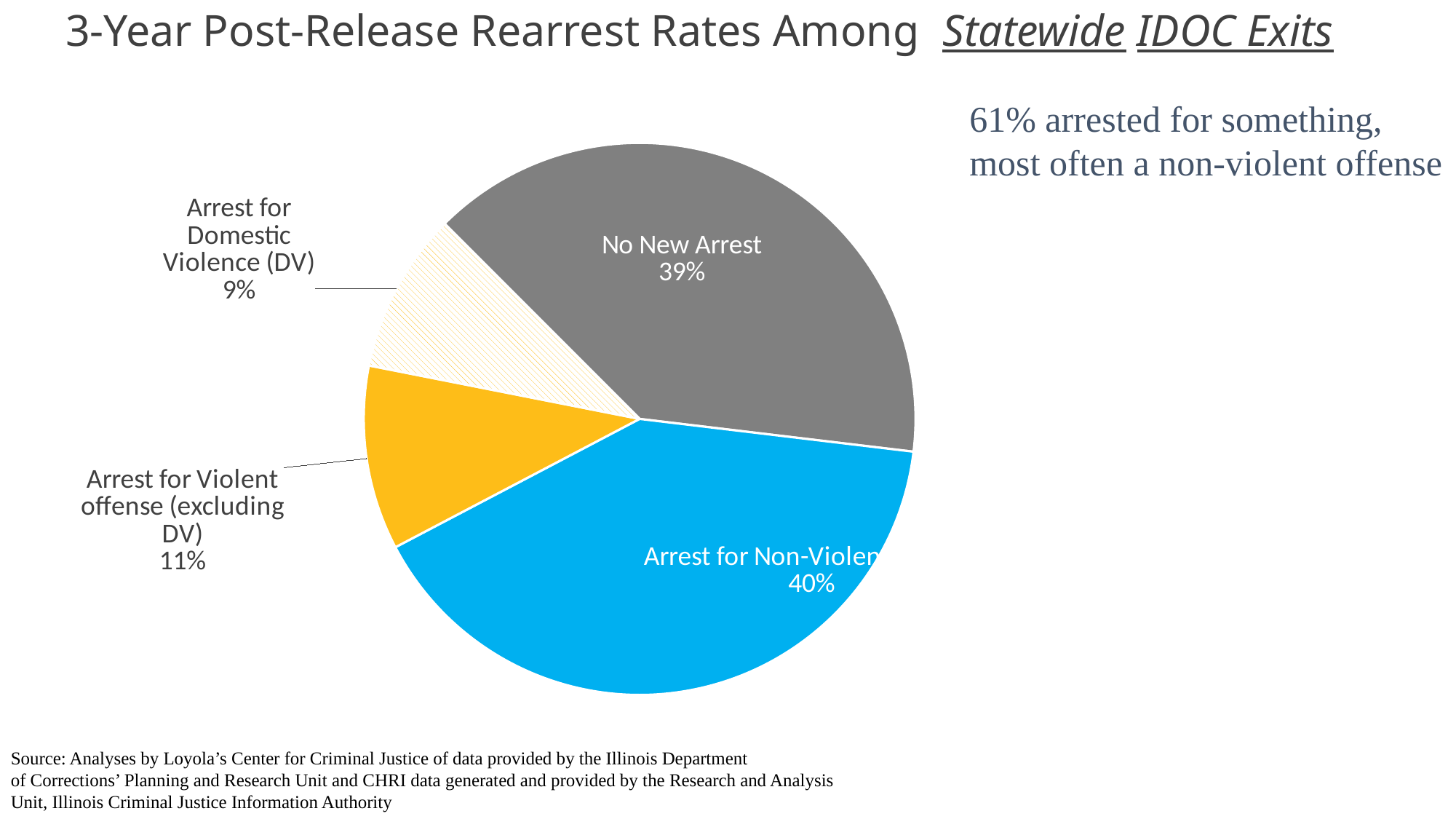
Which is larger: 'Arrest for Violent offense (excluding DV)' or 'Arrest for Domestic Violence (DV)'? Arrest for Violent offense (excluding DV) What is the title of the chart on the slide? 3-Year Post-Release Rearrest Rates Among Statewide IDOC Exits What colour is the 'Arrest for Non-Violent' slice? Blue Which slice of the pie chart is the largest? Arrest for Non-Violent What share of the pie is labelled 'Arrest for Non-Violent'? 40% How many slices does the pie chart have? 4 What percentage of statewide IDOC exits had no new arrest within 3 years? 39% What is the value for 'Arrest for Violent offense (excluding DV)'? 11% What is the value for 'Arrest for Domestic Violence (DV)'? 9% Which slice of the pie chart is the smallest? Arrest for Domestic Violence (DV) What kind of chart is shown on the slide? Pie chart How many percentage points larger is 'Arrest for Non-Violent' than 'Arrest for Violent offense (excluding DV)'? 29 percentage points